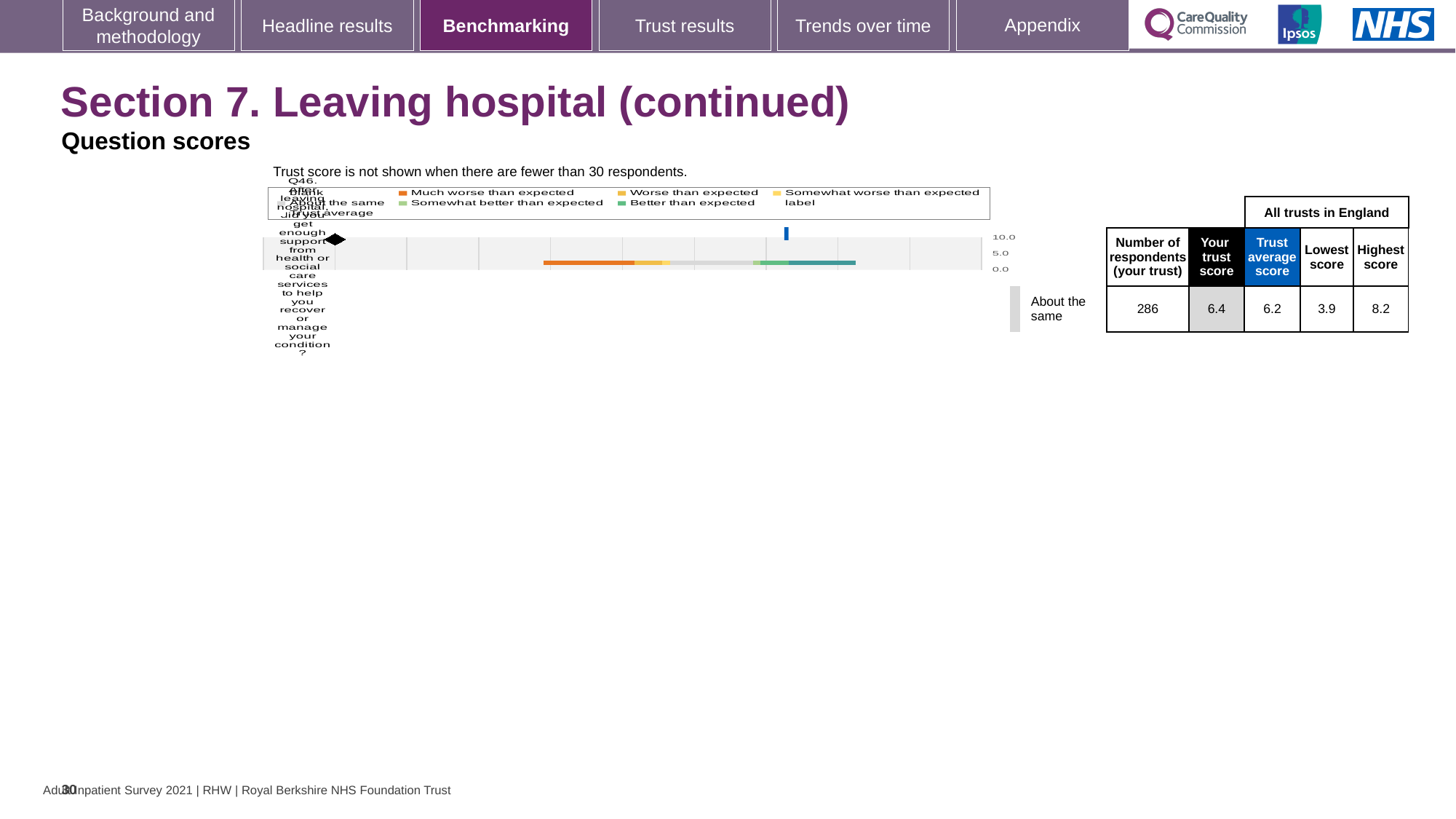
Which benchmark category is the trust's Q46 score placed in? About the same What is the trust average score for Q46 across all trusts in England? 6.2 What is the trust's score for Q46 (support from health or social care services after leaving hospital)? 6.4 By how much does the trust's score for Q46 exceed the trust average score? 0.2 What is the difference between the highest score and the lowest score for Q46? 4.3 Which is larger for Q46: the trust's own score or the trust average score? The trust's own score (6.4) How many respondents from the trust answered Q46? 286 What is the lowest score among all trusts in England for Q46? 3.9 What is the highest score among all trusts in England for Q46? 8.2 How many questions are plotted on the chart? 1 Is the trust's score for Q46 greater or less than 5.0 on the chart axis? greater What kind of chart is used to show the Q46 benchmarking result? Bar chart